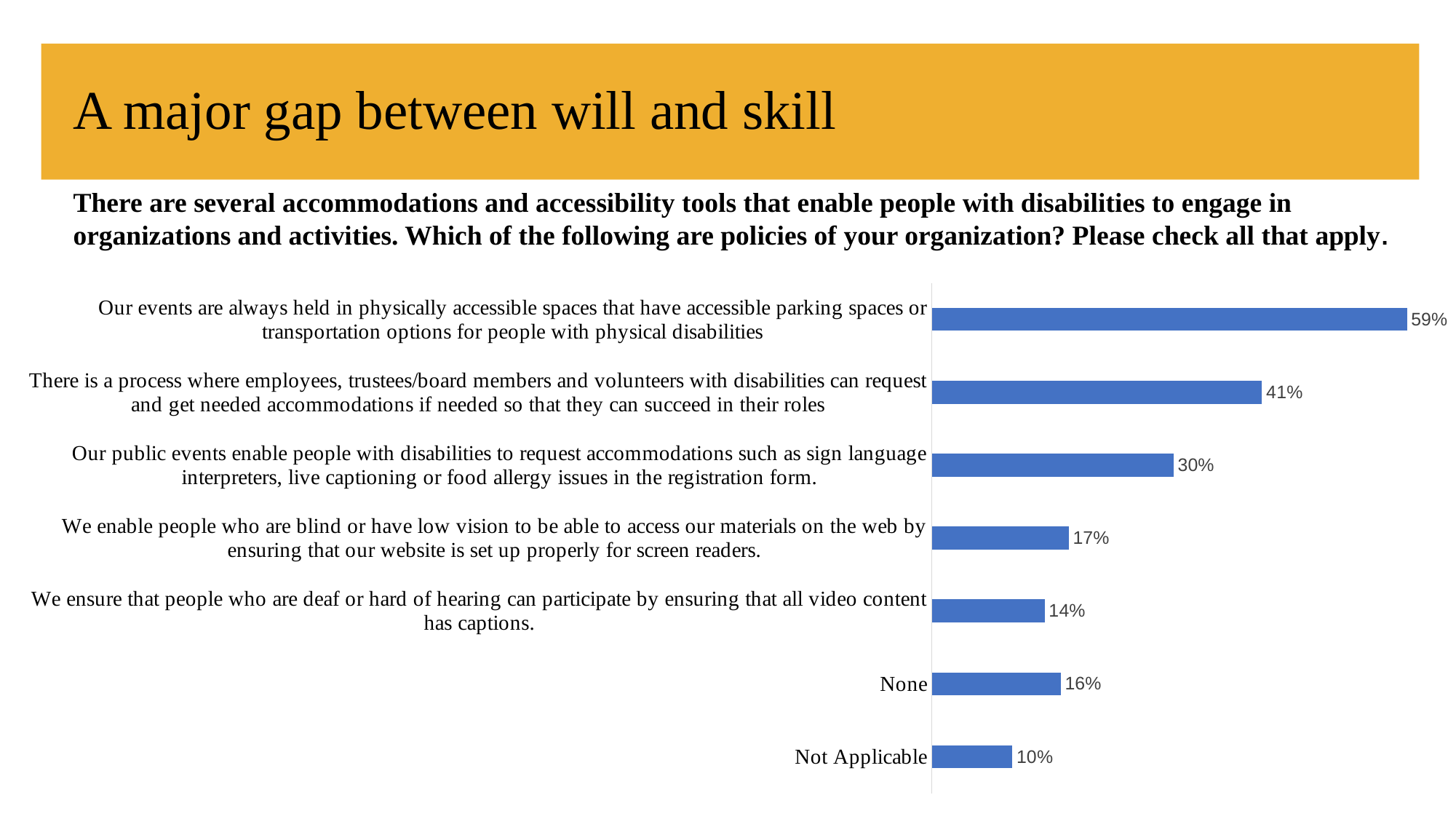
How many categories are shown in the chart? 7 What percentage of organizations say their events are always held in physically accessible spaces? 59% What is the difference between the value for events held in physically accessible spaces and the value for a process to request accommodations for employees, trustees/board members and volunteers? 18% Which is larger: the value for ensuring the website is set up for screen readers, or the value for 'None'? Ensuring the website is set up for screen readers (17%) What colour are the bars in the chart? Blue What percentage of organizations ensure that all video content has captions? 14% What kind of chart is shown on the slide? Bar chart What is the value for 'Not Applicable'? 10% What is the value for 'None'? 16% Which category has the highest value? Our events are always held in physically accessible spaces that have accessible parking spaces or transportation options for people with physical disabilities Which category has the lowest value? Not Applicable What is the value for public events enabling people to request accommodations such as sign language interpreters, live captioning or food allergy issues in the registration form? 30%